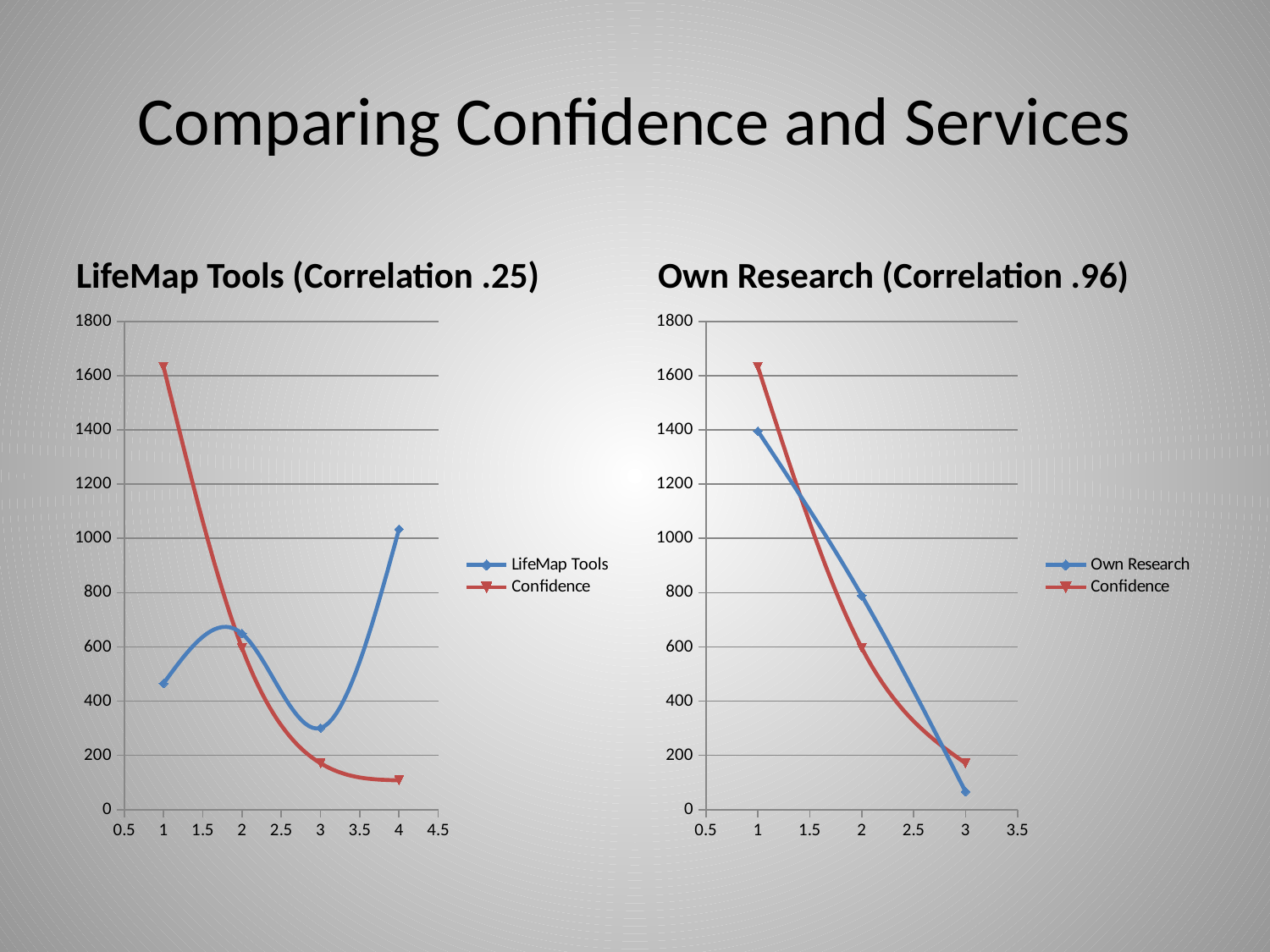
What are the legend entries of the Own Research (Correlation .96) chart? Own Research, Confidence In the Own Research (Correlation .96) chart, does the Own Research series rise or fall as x increases? fall In the LifeMap Tools (Correlation .25) chart, how many data points does the LifeMap Tools series have? 4 In the LifeMap Tools (Correlation .25) chart, is the Confidence value at x = 1 greater or less than 1600? greater In the LifeMap Tools (Correlation .25) chart, at which x value is the LifeMap Tools series highest? 4 How many series does the legend of the Own Research (Correlation .96) chart list? 2 In the LifeMap Tools (Correlation .25) chart, is the LifeMap Tools value at x = 4 greater or less than 800? greater What kind of chart is the LifeMap Tools (Correlation .25) chart? line chart How many series does the legend of the LifeMap Tools (Correlation .25) chart list? 2 In the Own Research (Correlation .96) chart, is the Own Research value at x = 2 greater or less than 1000? less In the LifeMap Tools (Correlation .25) chart, at x = 4, which series has the larger value, LifeMap Tools or Confidence? LifeMap Tools In the Own Research (Correlation .96) chart, how many data points does the Own Research series have? 3